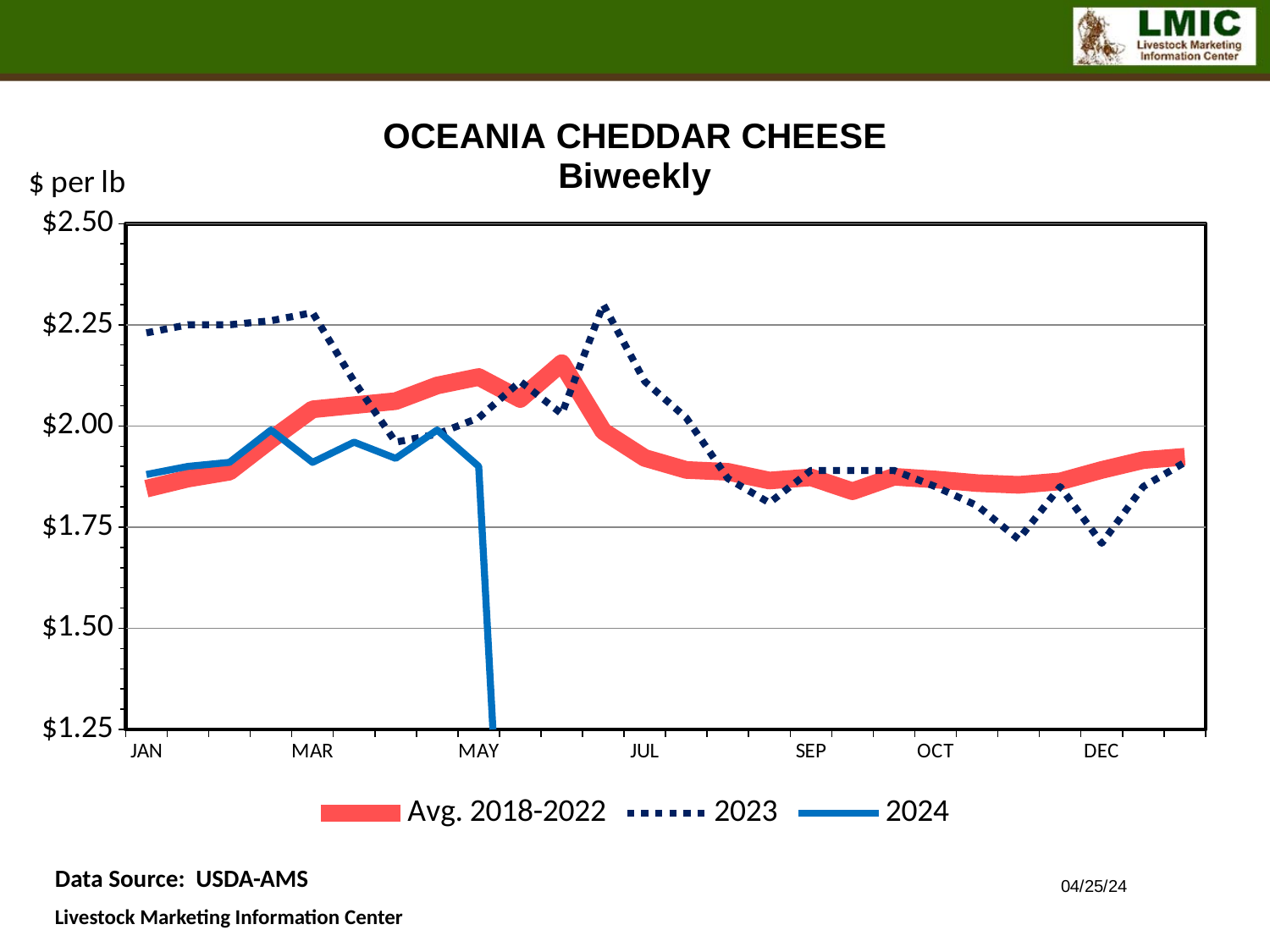
What is the title of the chart? OCEANIA CHEDDAR CHEESE Biweekly Does the 2023 series rise or fall from MAR to MAY? fall What unit is shown on the y axis of the chart? $ per lb Is the value for Avg. 2018-2022 in JAN greater or less than $2.00? less Is the value for 2023 in JAN greater or less than $2.00? greater What kind of chart is shown on the slide? line chart How many series does the legend list? 3 Is the value for 2024 in MAR greater or less than $2.00? less Which series has the higher value in MAR, 2023 or 2024? 2023 Which series reaches the highest value anywhere on the chart? 2023 Which series has the higher value in JAN, 2023 or Avg. 2018-2022? 2023